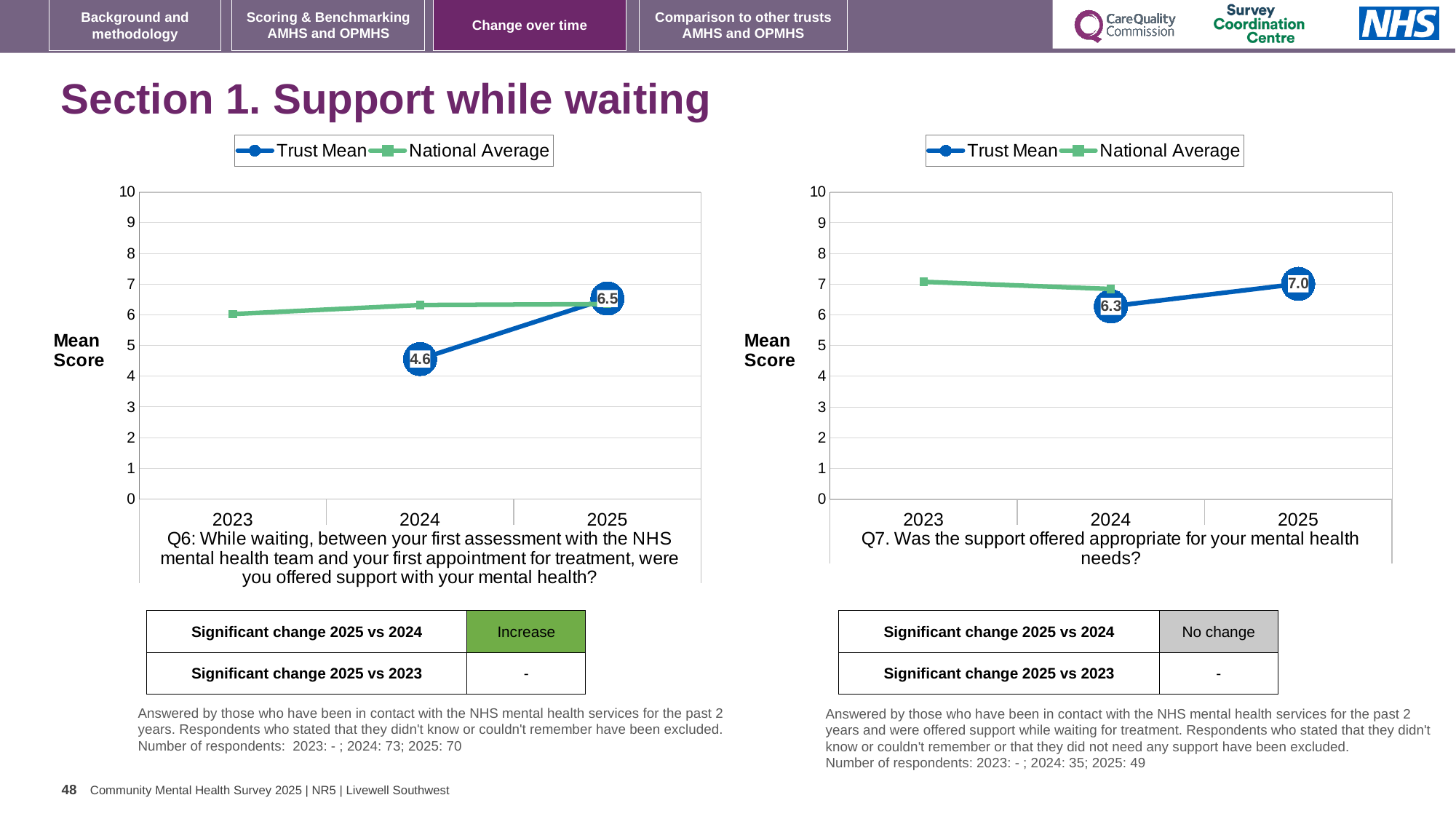
In the left chart (Q6), does the Trust Mean rise or fall from 2024 to 2025? rise In the right chart (Q7), what is the Trust Mean score for 2025? 7.0 In the right chart (Q7), what is the Trust Mean score for 2024? 6.3 In the left chart (Q6), what is the Trust Mean score for 2025? 6.5 How many series does the legend of the right chart (Q7) list? 2 In the left chart (Q6), which is larger in 2024, the Trust Mean or the National Average? National Average In the left chart (Q6), what is the Trust Mean score for 2024? 4.6 What type of chart is the left chart (Q6)? line chart In the left chart (Q6), by how much did the Trust Mean change from 2024 to 2025? 1.9 In the right chart (Q7), what is the difference between the Trust Mean in 2025 and 2024? 0.7 In the left chart (Q6), is the National Average for 2023 greater or less than 5? greater